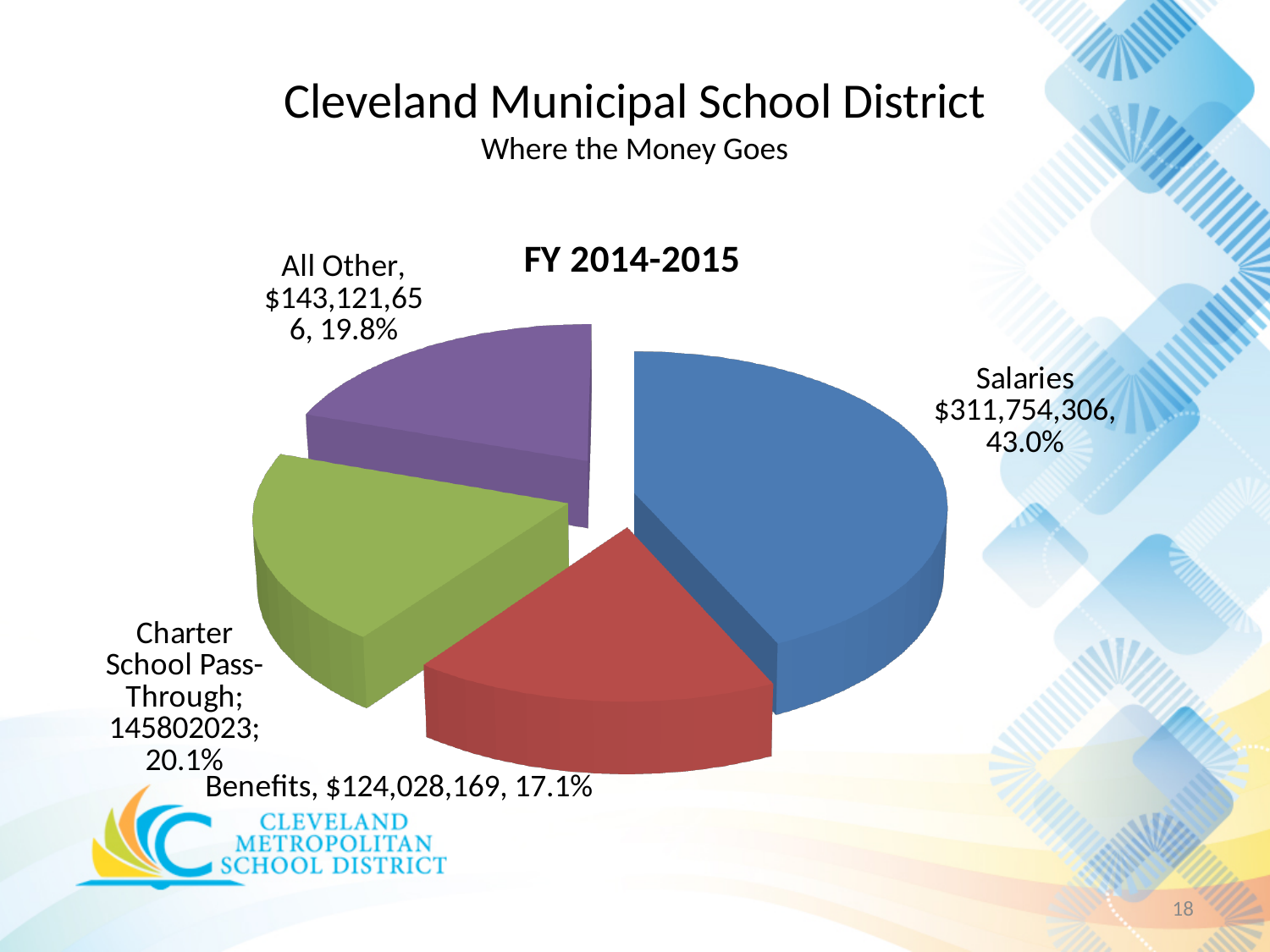
What is the dollar value shown for All Other? $143,121,656 Which has a larger share, Charter School Pass-Through or All Other? Charter School Pass-Through What is the difference in dollars between Salaries and Benefits? $187,726,137 Which category has the largest slice of the pie? Salaries What is the dollar value shown for Salaries? $311,754,306 What is the dollar value shown for Benefits? $124,028,169 What kind of chart is shown on the slide? Pie chart How many slices does the pie chart have? 4 What is the title of the chart? FY 2014-2015 What percentage share of the pie is Charter School Pass-Through? 20.1% What percentage share of the pie is Salaries? 43.0% Which category has the smallest slice of the pie? Benefits